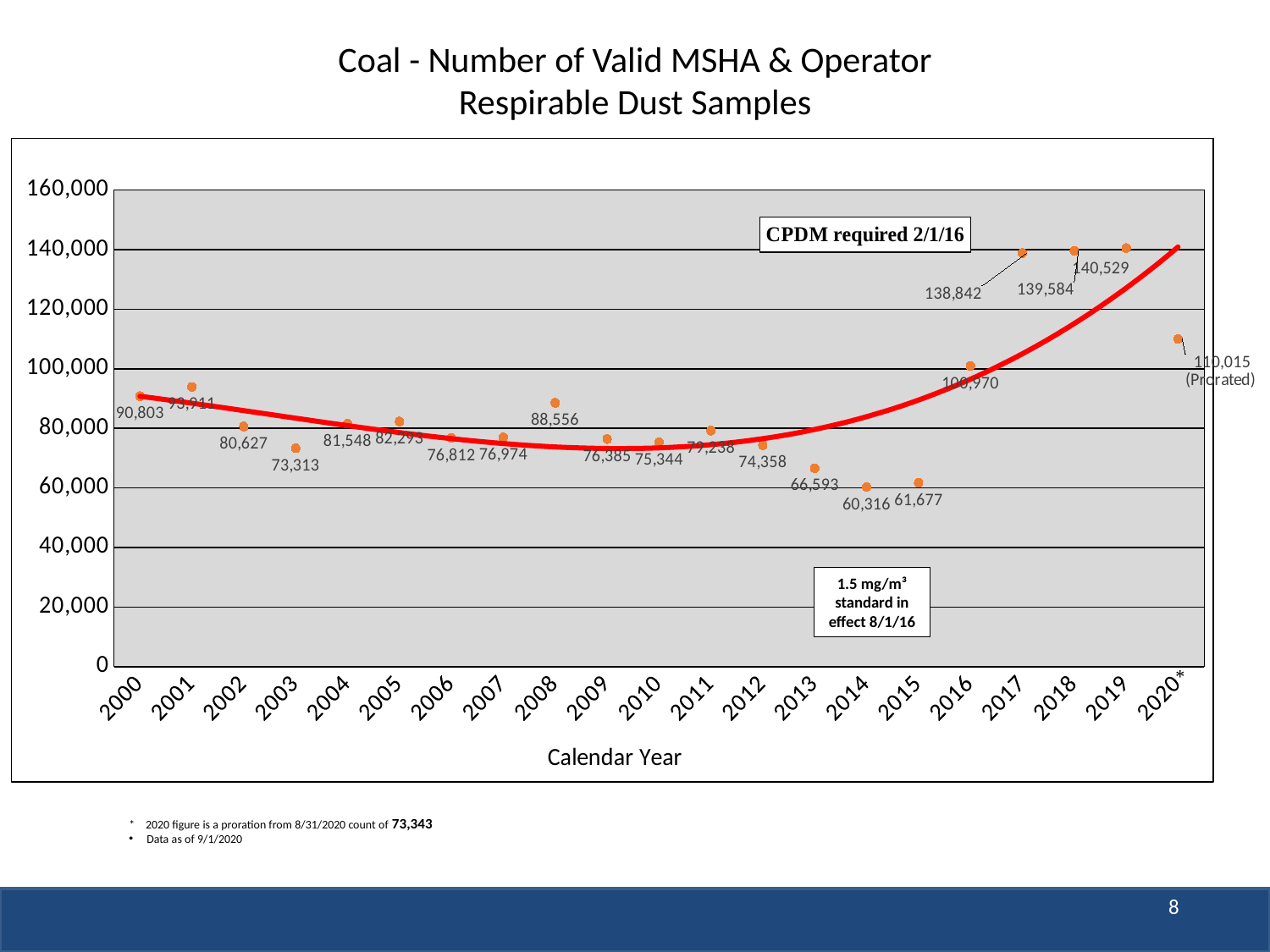
What is the value plotted for 2019? 140,529 What is the x-axis title of the chart? Calendar Year What is the difference between the 2017 value and the 2016 value? 37,872 Which year has the larger value, 2008 or 2004? 2008 Which calendar year has the lowest number of samples? 2014 How many calendar years are plotted on the x axis? 21 What is the number of valid respirable dust samples for 2000? 90,803 What is the prorated value shown for 2020*? 110,015 Which calendar year has the highest number of samples? 2019 What is the difference between the 2019 value and the 2018 value? 945 What is the value plotted for 2014? 60,316 Is the value for 2013 greater or less than 80,000? less